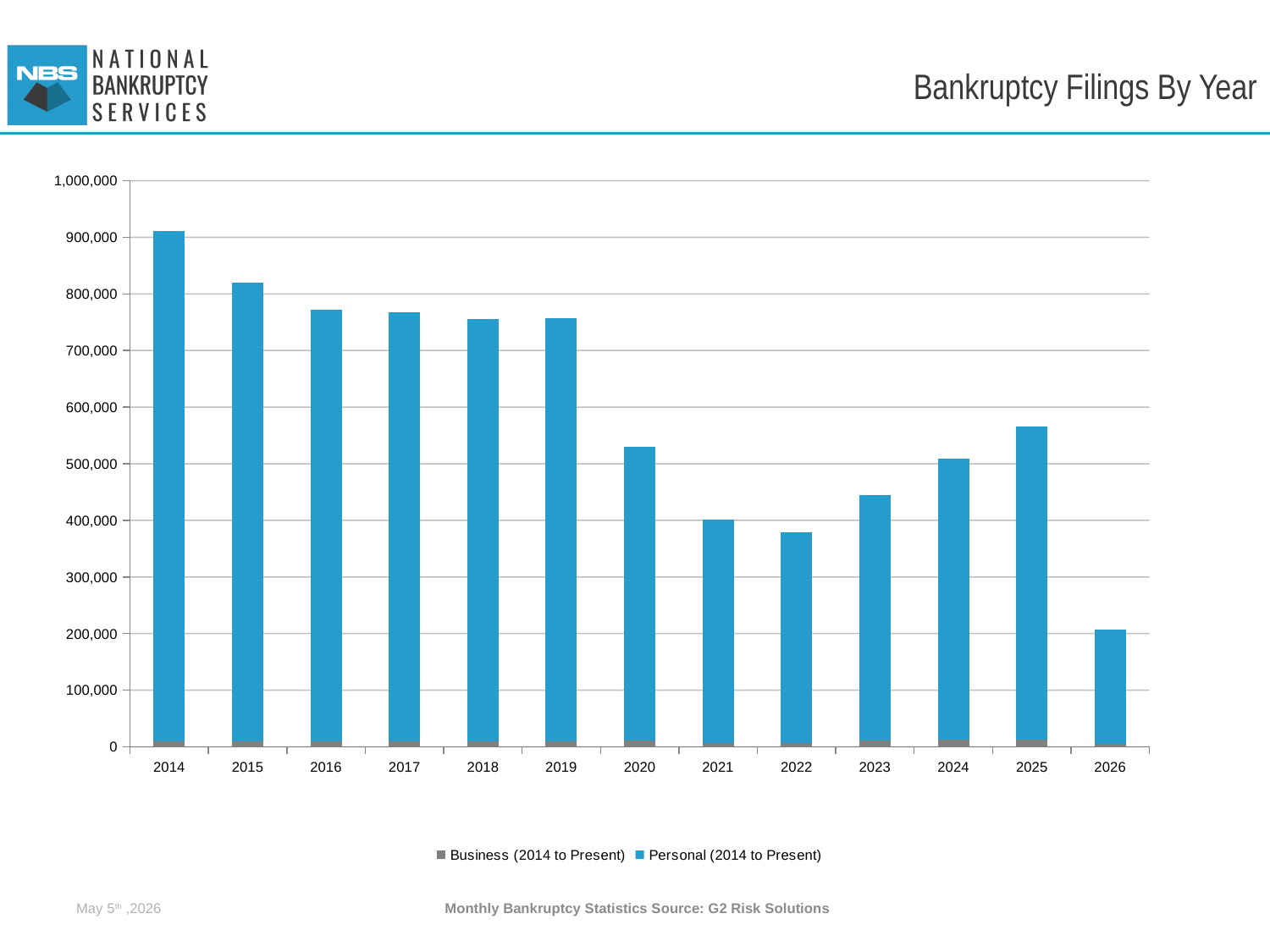
What is the title of the chart? Bankruptcy Filings By Year What kind of chart is shown on the slide? Bar chart Which year has the lowest total bankruptcy filings? 2026 How many years are shown on the x axis of the chart? 13 How many series does the legend list? 2 Is the total value for 2026 greater or less than 300,000? less Is the total value for 2025 greater or less than 500,000? greater Which year has the highest total bankruptcy filings? 2014 Is the total value for 2022 greater or less than 400,000? less Which year has the larger total, 2015 or 2016? 2015 Do total filings rise or fall from 2022 to 2025? Rise